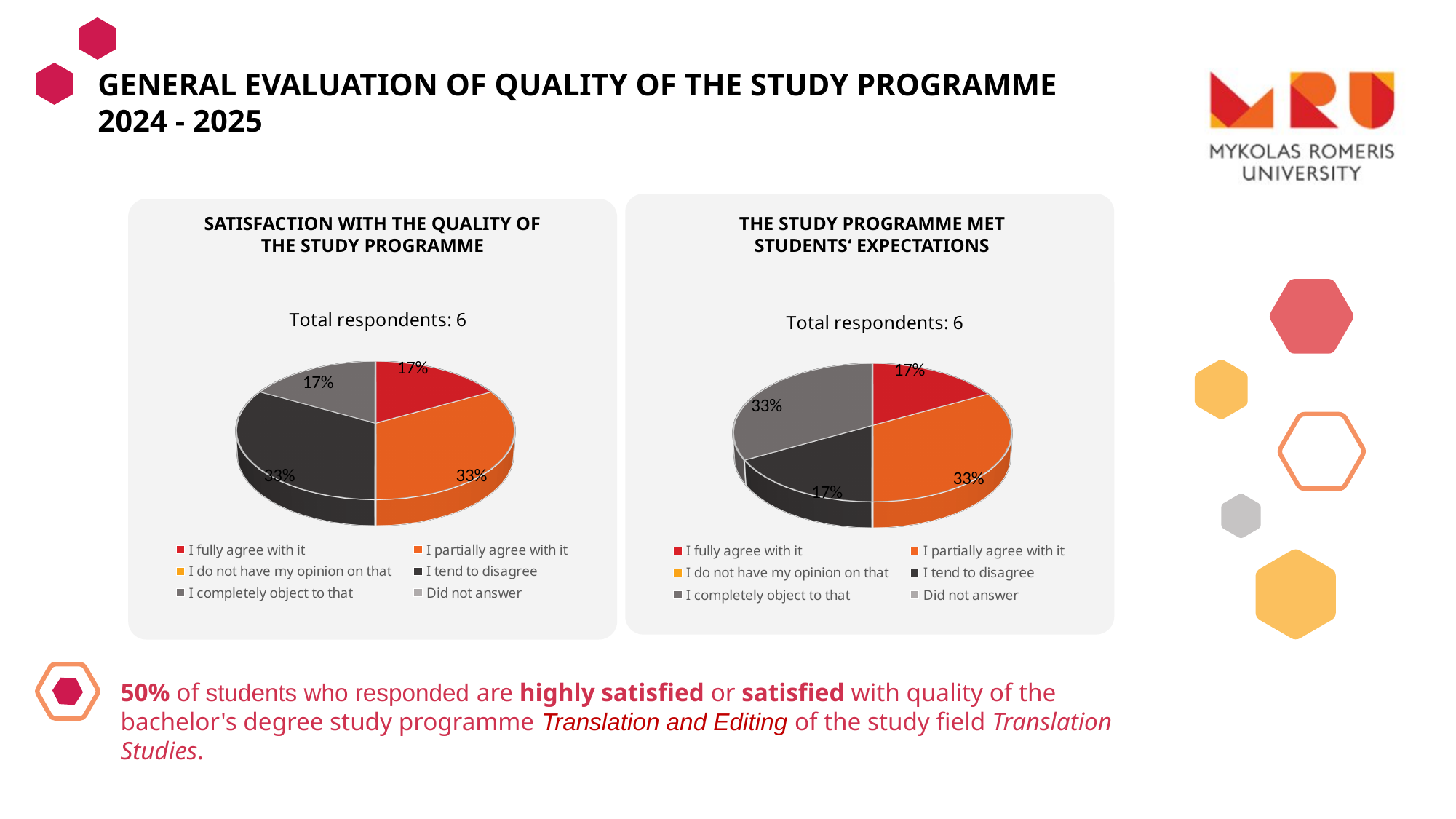
In 'The study programme met students' expectations' chart, what share of respondents chose 'I fully agree with it'? 17% In 'The study programme met students' expectations' chart, what share of respondents chose 'I partially agree with it'? 33% How many entries does the legend of the 'Satisfaction with the quality of the study programme' chart list? 6 In the 'Satisfaction with the quality of the study programme' chart, what share of respondents chose 'I partially agree with it'? 33% In the 'Satisfaction with the quality of the study programme' chart, what share of respondents chose 'I fully agree with it'? 17% In the 'Satisfaction with the quality of the study programme' chart, what share of respondents chose 'I tend to disagree'? 33% In the 'Satisfaction with the quality of the study programme' chart, what is the difference in percentage points between 'I partially agree with it' and 'I fully agree with it'? 16 percentage points How many total respondents are reported for 'The study programme met students' expectations' chart? 6 What kind of chart is used in the 'Satisfaction with the quality of the study programme' panel? Pie chart In 'The study programme met students' expectations' chart, which is larger: the share for 'I partially agree with it' or for 'I tend to disagree'? I partially agree with it In 'The study programme met students' expectations' chart, what share of respondents chose 'I tend to disagree'? 17% How many slices are shown in the 'Satisfaction with the quality of the study programme' pie chart? 4